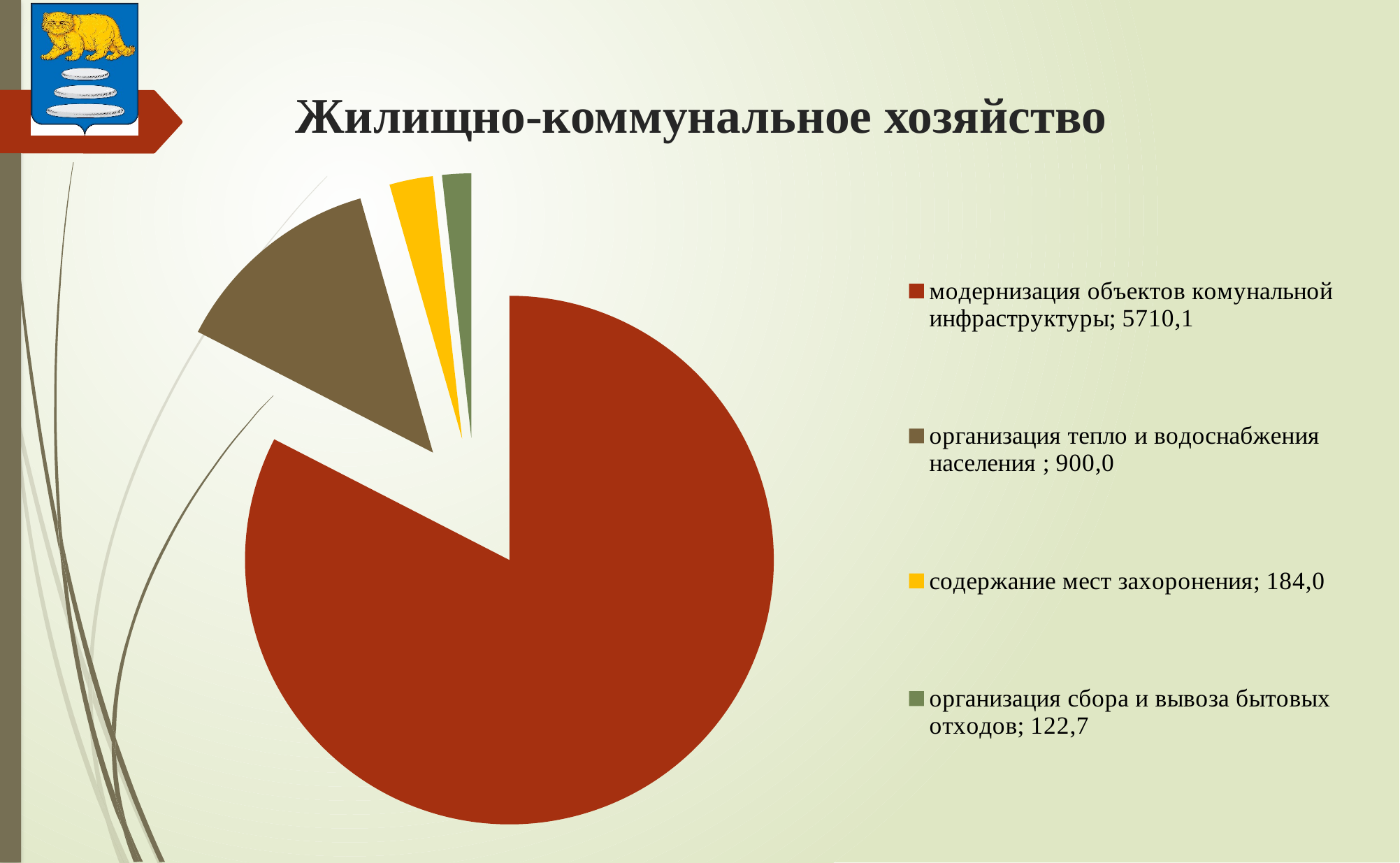
Which category has the smallest slice of the pie? организация сбора и вывоза бытовых отходов What is the value for "организация тепло и водоснабжения населения"? 900,0 What is the difference between the values for "модернизация объектов комунальной инфраструктуры" and "организация тепло и водоснабжения населения"? 4810,1 What is the value for "содержание мест захоронения"? 184,0 What is the value for "организация сбора и вывоза бытовых отходов"? 122,7 What is the value for "модернизация объектов комунальной инфраструктуры"? 5710,1 Which is larger: the value for "организация тепло и водоснабжения населения" or for "содержание мест захоронения"? организация тепло и водоснабжения населения What is the title of the slide containing the pie chart? Жилищно-коммунальное хозяйство Which category has the largest slice of the pie? модернизация объектов комунальной инфраструктуры What kind of chart is shown on the slide? pie chart What is the difference between the values for "содержание мест захоронения" and "организация сбора и вывоза бытовых отходов"? 61,3 How many categories does the pie chart have? 4